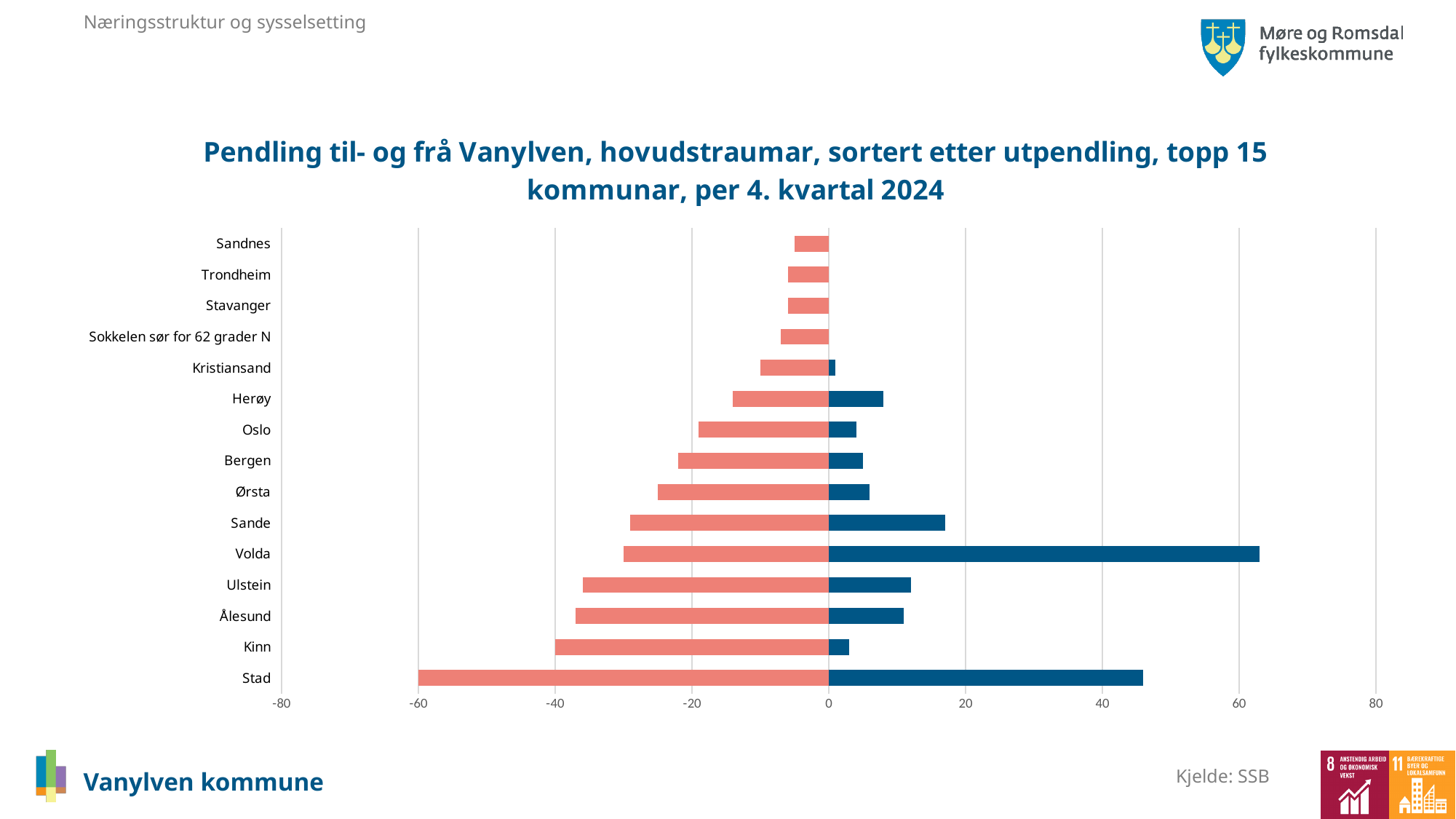
Which has the larger blue bar, Sande or Ulstein? Sande Is the blue bar value for Volda greater or less than 60? greater What is the title of the chart? Pendling til- og frå Vanylven, hovudstraumar, sortert etter utpendling, topp 15 kommunar, per 4. kvartal 2024 Is the blue bar value for Stad greater or less than 40? greater Which has the larger blue bar, Volda or Stad? Volda Is the red bar value for Ulstein greater or less than -20? less Which municipality has the longest blue (positive) bar in the chart? Volda What kind of chart is shown on the slide? bar chart How many municipalities (categories) are listed on the vertical axis of the chart? 15 Which municipality has the longest red (negative) bar in the chart? Stad What value does the red bar for Stad reach on the horizontal axis? -60